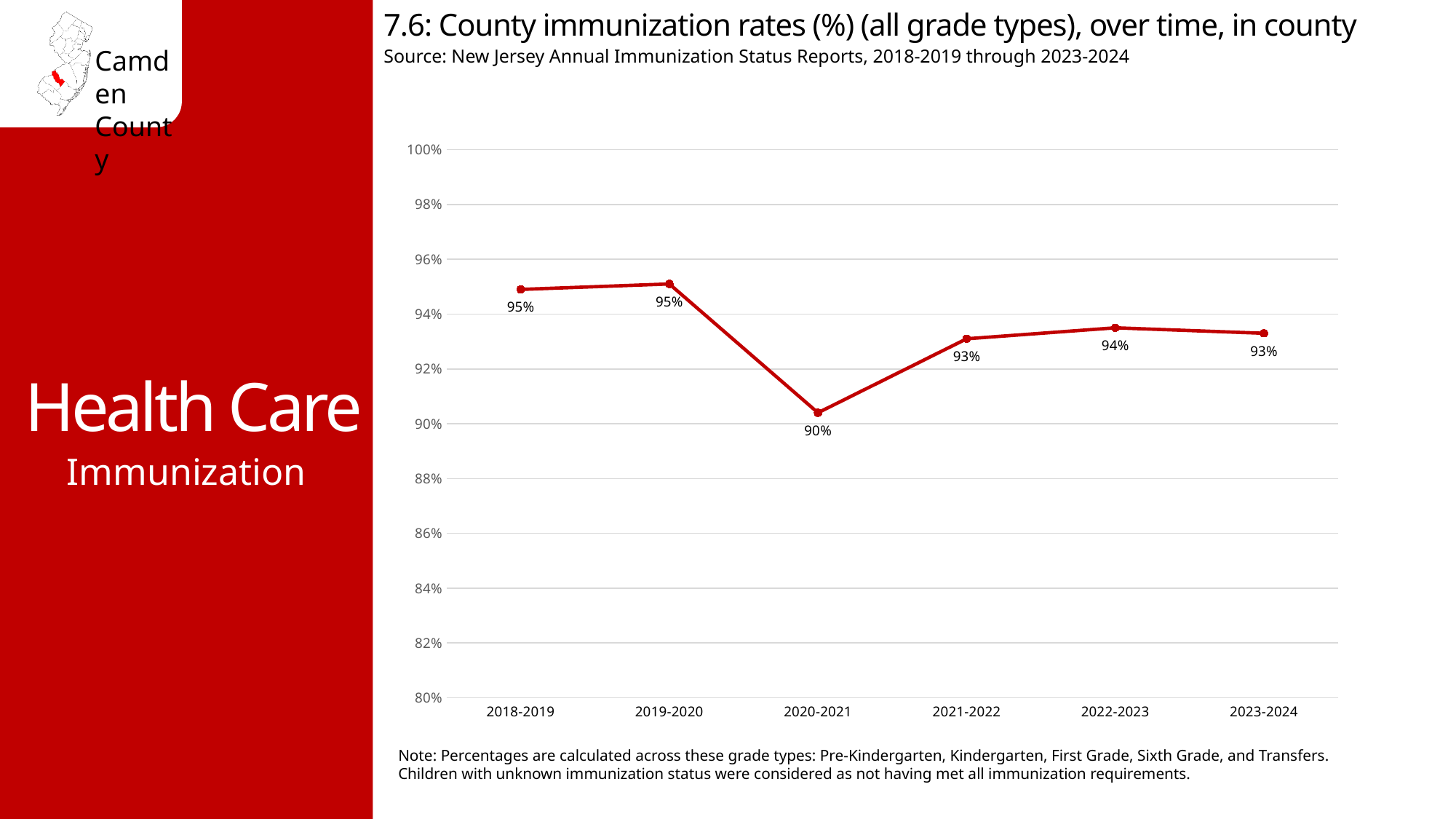
What is the county immunization rate for 2022-2023? 94% What kind of chart is shown on the slide? Line chart Which year has the higher immunization rate, 2020-2021 or 2022-2023? 2022-2023 Does the immunization rate rise or fall from 2020-2021 to 2022-2023? Rise What is the source cited for the chart data? New Jersey Annual Immunization Status Reports, 2018-2019 through 2023-2024 How many school years are plotted on the chart? 6 Is the value for 2020-2021 greater or less than 92%? less Is the value for 2019-2020 greater or less than 94%? greater What is the difference in percentage points between the 2018-2019 rate and the 2020-2021 rate? 5 percentage points What is the county immunization rate for 2020-2021? 90% Which school year has the lowest immunization rate? 2020-2021 What is the county immunization rate for 2023-2024? 93%